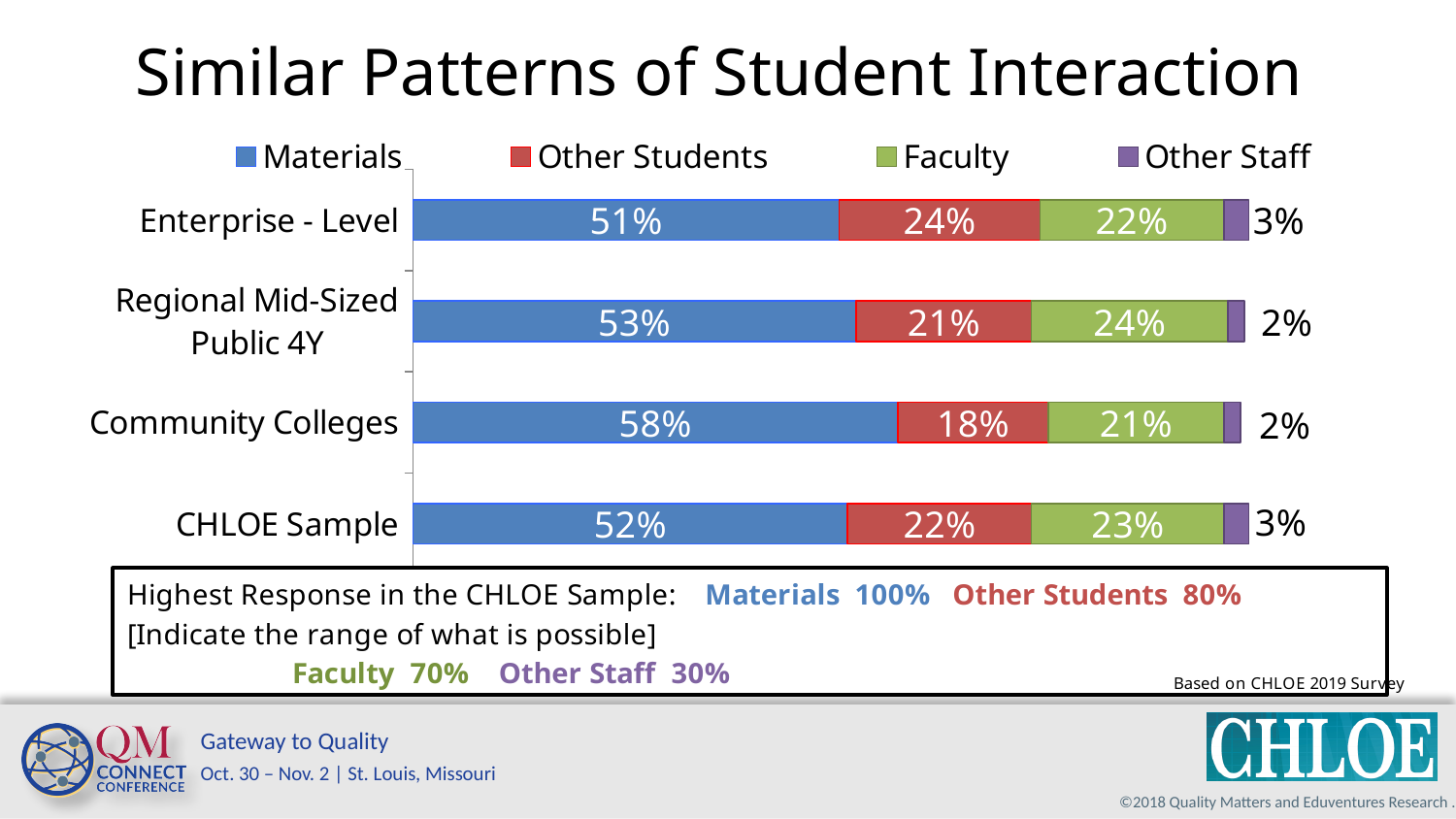
How many categories are shown on the chart? 4 What is the Other Students value for Enterprise - Level? 24% What is the Faculty value for Regional Mid-Sized Public 4Y? 24% What is the Materials value for Community Colleges? 58% How many series does the legend list? 4 Which is larger, the Faculty value for Enterprise - Level or the Faculty value for the CHLOE Sample? CHLOE Sample What is the difference between the Materials values for Community Colleges and Enterprise - Level? 7% Which category has the lowest Other Students value? Community Colleges What is the total of the stacked bar for Enterprise - Level? 100% What kind of chart is shown on the slide? Stacked bar chart What is the Other Staff value for the CHLOE Sample? 3% Which category has the highest Materials value? Community Colleges